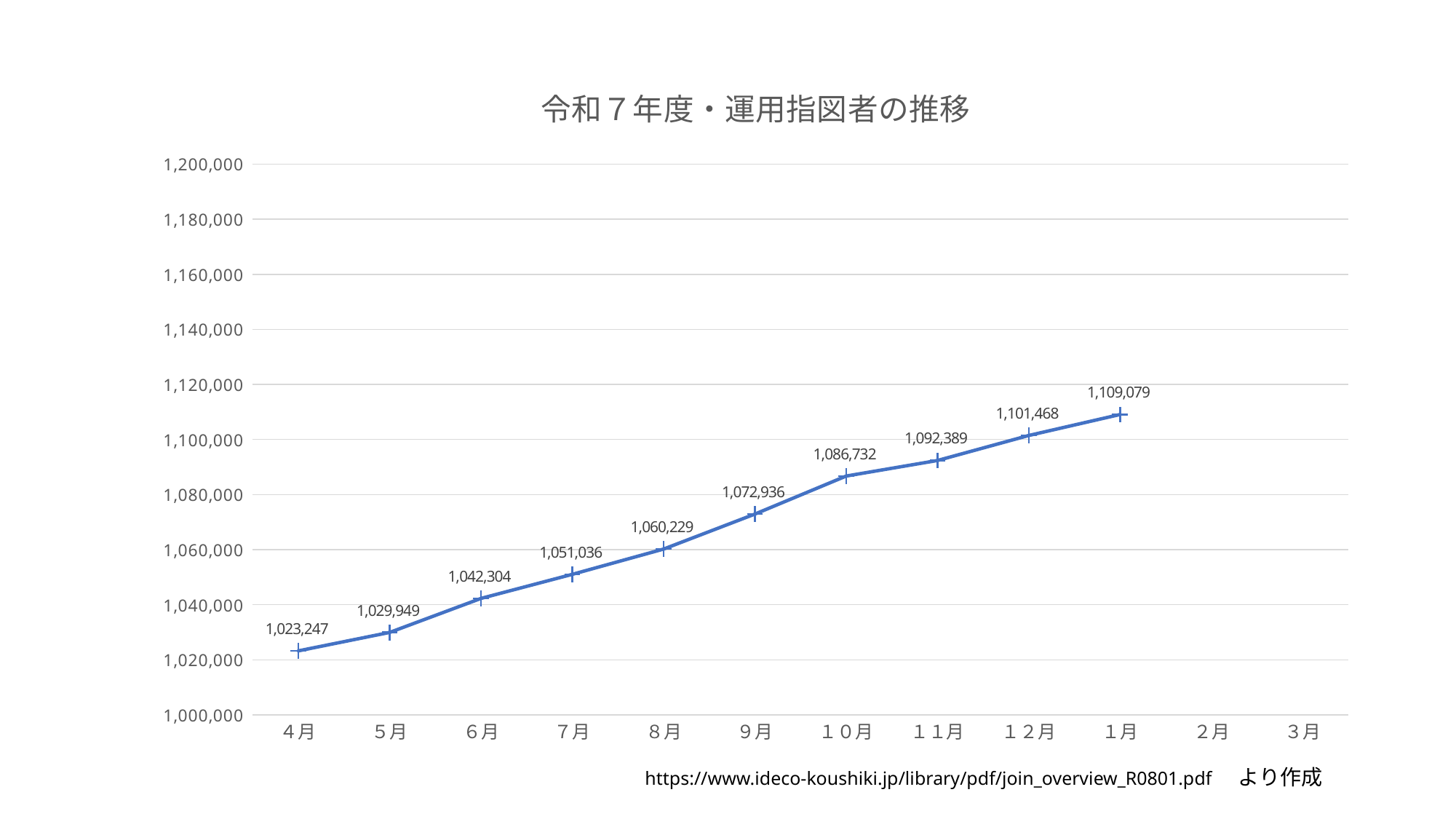
What is the difference between the values for 1月 and 4月? 85,832 Which is larger, the value for 7月 or the value for 8月? 8月 What is the value for 1月? 1,109,079 How many data points are plotted on the line? 10 Which month has the highest plotted value? 1月 Which month has the lowest plotted value? 4月 Is the value for 9月 greater or less than 1,080,000? less What is the value for 4月? 1,023,247 What is the value for 9月? 1,072,936 What is the difference between the values for 12月 and 11月? 9,079 Do the values rise or fall from 4月 to 1月? rise What kind of chart is shown on the slide? line chart